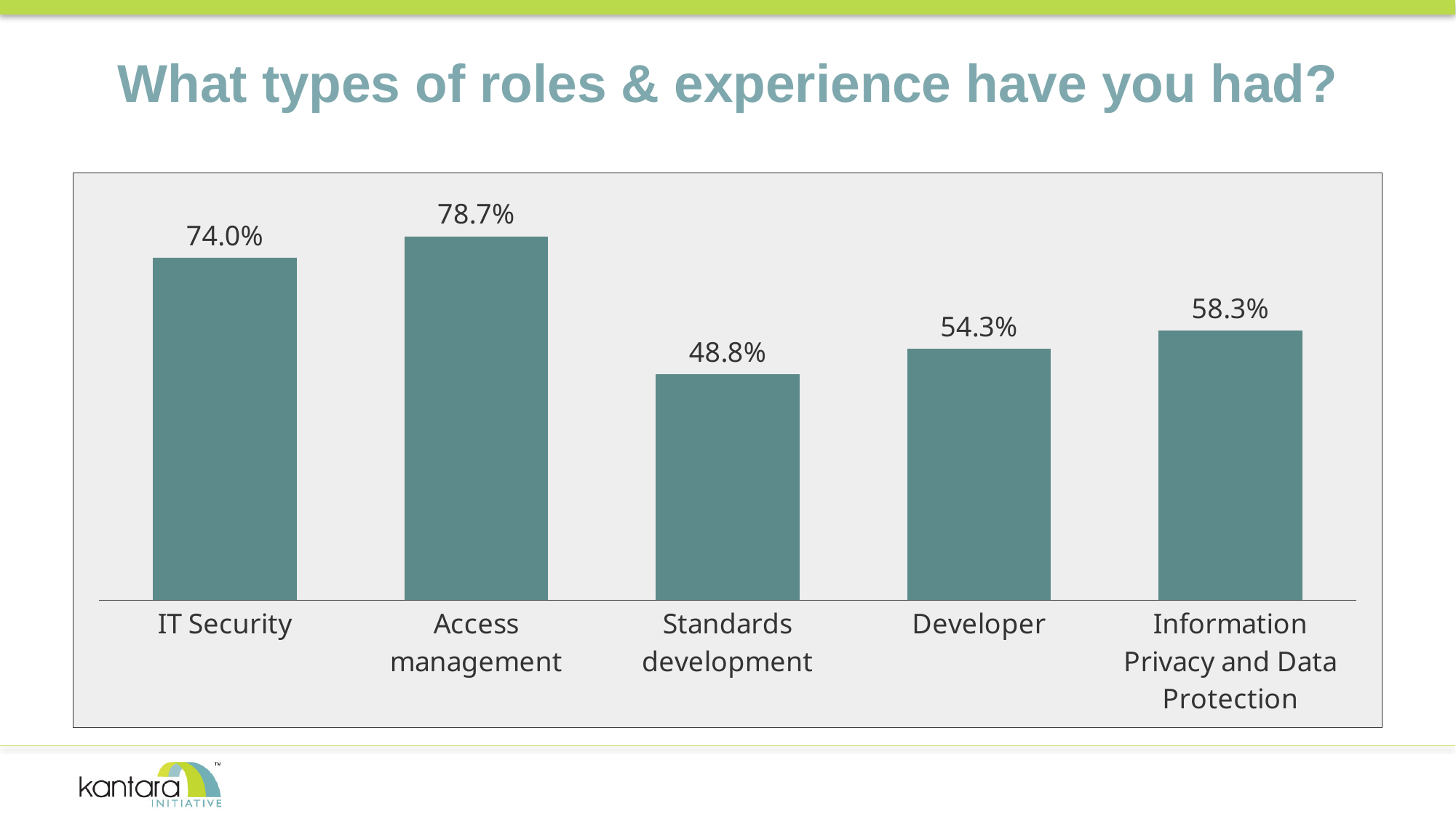
Which category has the lowest value? Standards development What is the value for Developer? 54.3% What kind of chart is shown on the slide? Bar chart What is the value for IT Security? 74.0% What is the value for Access management? 78.7% What is the title of the slide? What types of roles & experience have you had? What is the difference between the values for Access management and IT Security? 4.7% Which category has the highest value? Access management What is the value for Standards development? 48.8% What is the value for Information Privacy and Data Protection? 58.3% How many categories are shown in the chart? 5 Which is larger, the value for Developer or the value for Information Privacy and Data Protection? Information Privacy and Data Protection